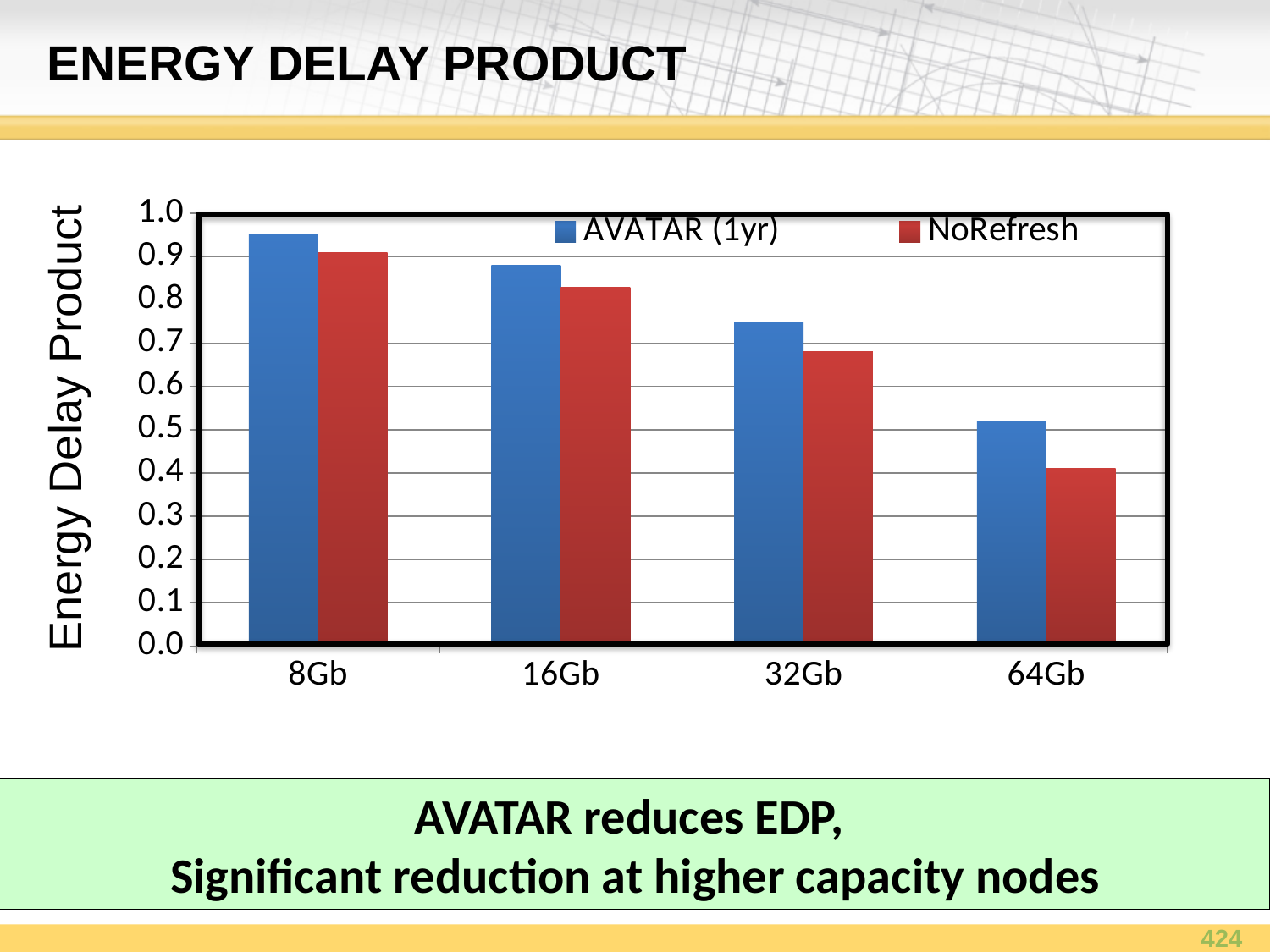
Is the AVATAR (1yr) value for 8Gb greater or less than 0.9? greater Which capacity has the lowest NoRefresh value? 64Gb Is the NoRefresh value for 32Gb greater or less than 0.6? greater Is the AVATAR (1yr) value for 64Gb greater or less than 0.6? less Do the AVATAR (1yr) values rise or fall as capacity increases from 8Gb to 64Gb? fall Which capacity has the highest AVATAR (1yr) value? 8Gb How many series does the legend list? 2 What kind of chart is shown on the slide? bar chart At 64Gb, which is larger: AVATAR (1yr) or NoRefresh? AVATAR (1yr) What is the label on the y axis? Energy Delay Product How many capacity categories are shown on the x axis? 4